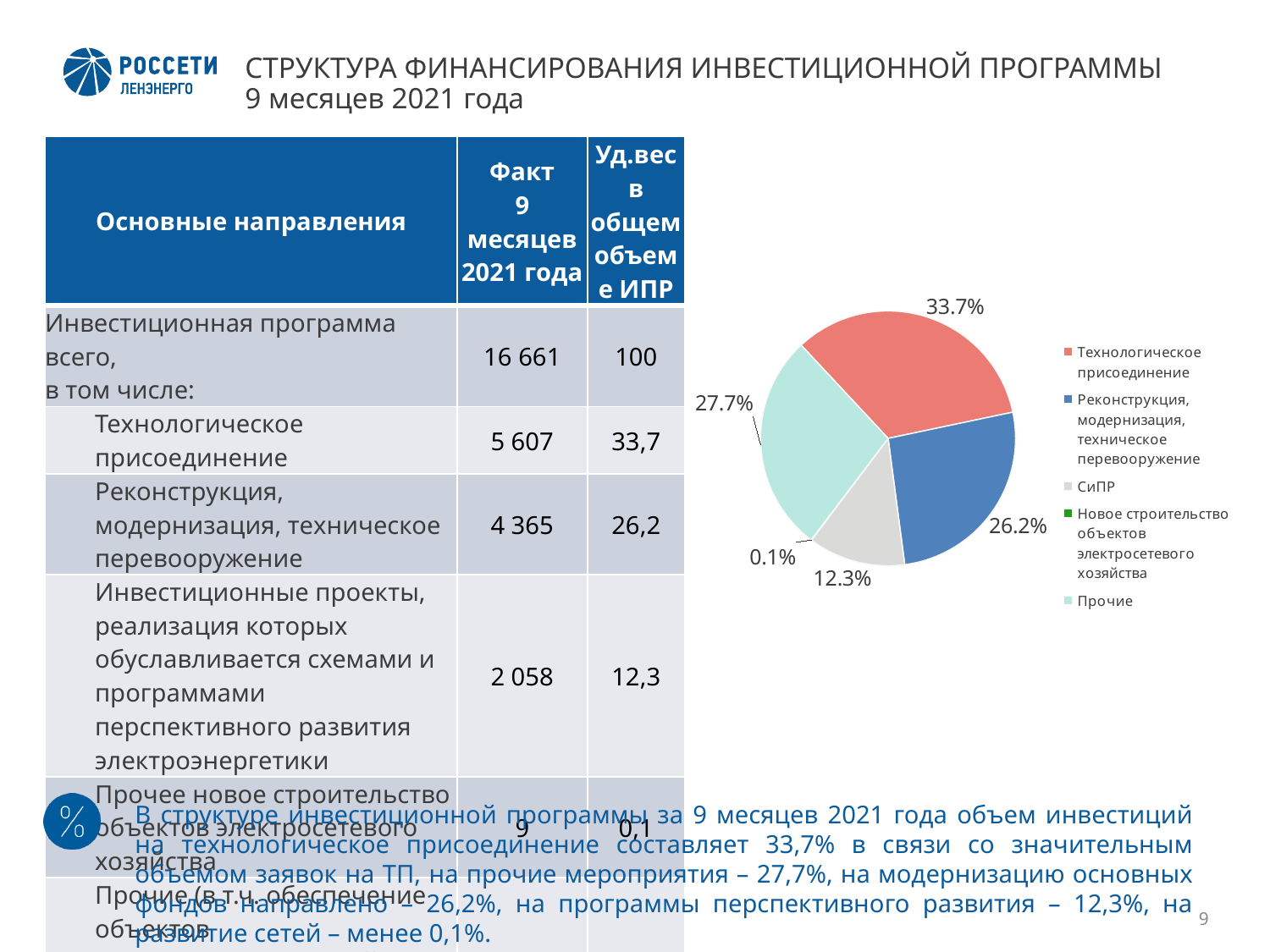
What type of chart is shown on the slide? pie chart What colour is the slice for Технологическое присоединение in the pie chart? red How many slices does the pie chart have? 5 What share of the pie chart does Технологическое присоединение have? 33.7% Which is larger in the pie chart: Прочие or Реконструкция, модернизация, техническое перевооружение? Прочие What is the value shown for Прочие in the pie chart? 27.7% Which category has the smallest slice in the pie chart? Новое строительство объектов электросетевого хозяйства What is the value shown for СиПР in the pie chart? 12.3% What is the difference between the shares of Технологическое присоединение and СиПР in the pie chart? 21.4% Which category has the largest slice in the pie chart? Технологическое присоединение What is the value shown for Реконструкция, модернизация, техническое перевооружение in the pie chart? 26.2% What is the value shown for Новое строительство объектов электросетевого хозяйства in the pie chart? 0.1%